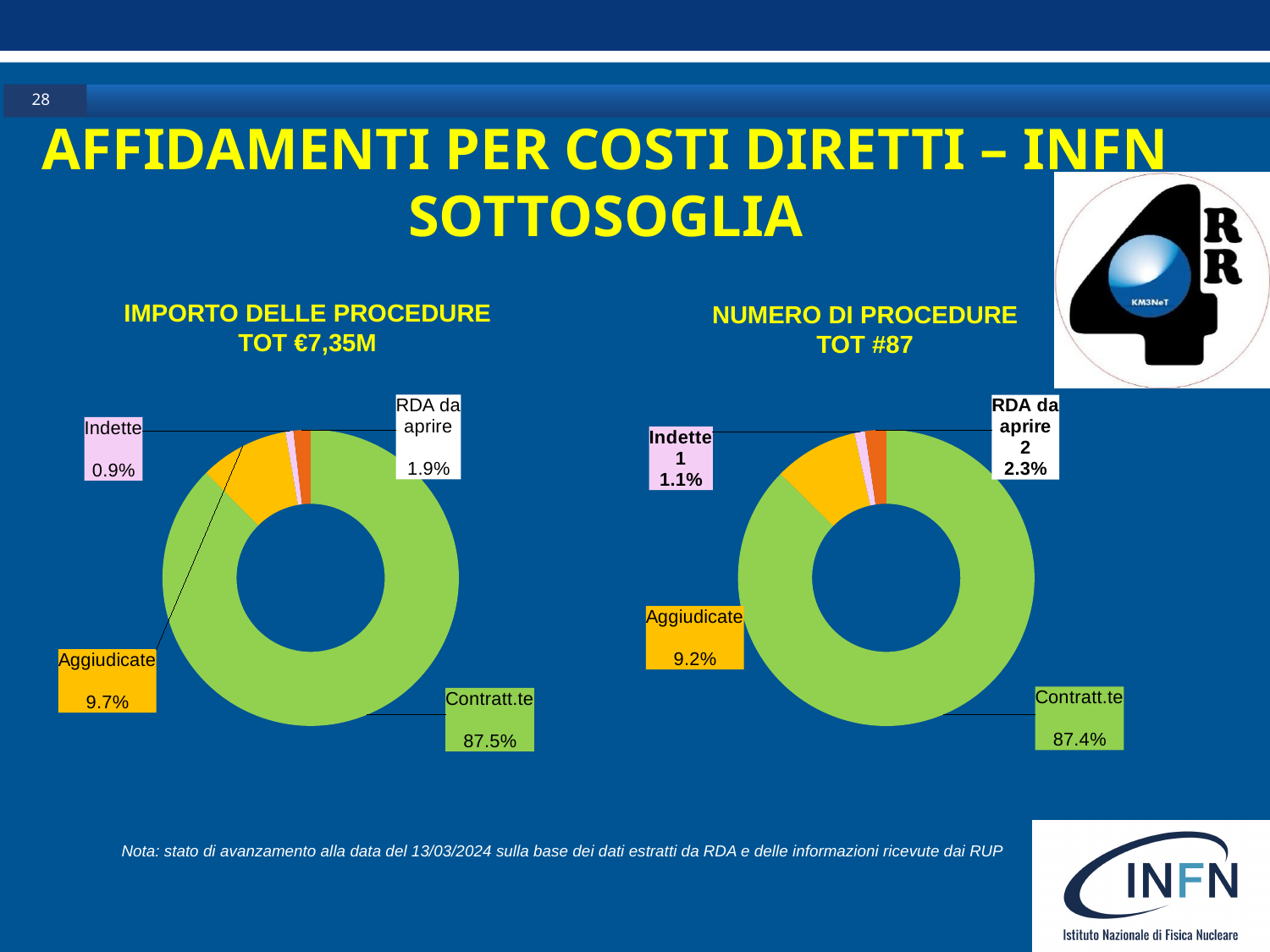
In the IMPORTO DELLE PROCEDURE chart, which category has the smallest share? Indette In the NUMERO DI PROCEDURE chart, which category has the largest share? Contratt.te In the NUMERO DI PROCEDURE chart, what share does RDA da aprire have? 2.3% What total is stated in the title of the NUMERO DI PROCEDURE chart? TOT #87 In the IMPORTO DELLE PROCEDURE chart, what share does Aggiudicate have? 9.7% In the IMPORTO DELLE PROCEDURE chart, how many categories are shown? 4 In the NUMERO DI PROCEDURE chart, what share does Contratt.te have? 87.4% In the NUMERO DI PROCEDURE chart, what is the difference in share between Aggiudicate and RDA da aprire? 6.9% What kind of chart is used for IMPORTO DELLE PROCEDURE? Pie (donut) chart In the NUMERO DI PROCEDURE chart, how many procedures are Indette? 1